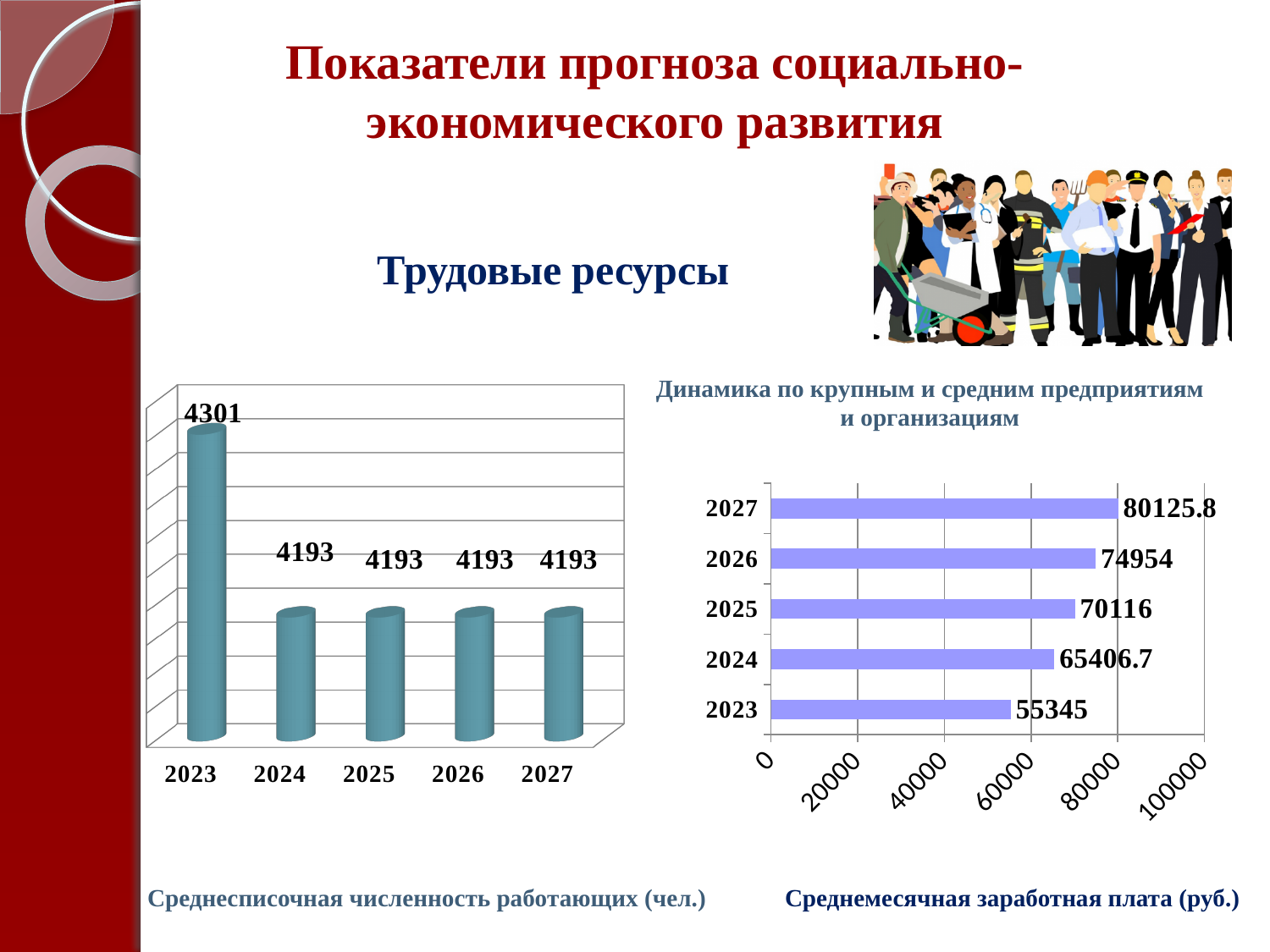
In the right chart (Среднемесячная заработная плата), which year has the lowest value? 2023 In the right chart (Среднемесячная заработная плата), is the value for 2025 greater or less than 60000? greater In the left chart (Среднесписочная численность работающих), how many years are shown on the x axis? 5 In the right chart (Среднемесячная заработная плата), what is the value for 2027? 80125.8 In the left chart (Среднесписочная численность работающих), what is the difference between the values for 2023 and 2024? 108 In the left chart (Среднесписочная численность работающих), which year has the highest value? 2023 In the left chart (Среднесписочная численность работающих), what is the value for 2023? 4301 In the right chart (Среднемесячная заработная плата), what is the difference between the values for 2026 and 2025? 4838 In the right chart (Среднемесячная заработная плата), do the values rise or fall from 2023 to 2027? rise In the left chart (Среднесписочная численность работающих), what is the value for 2025? 4193 What kind of chart is the right chart (Среднемесячная заработная плата)? bar chart In the right chart (Среднемесячная заработная плата), what is the value for 2024? 65406.7